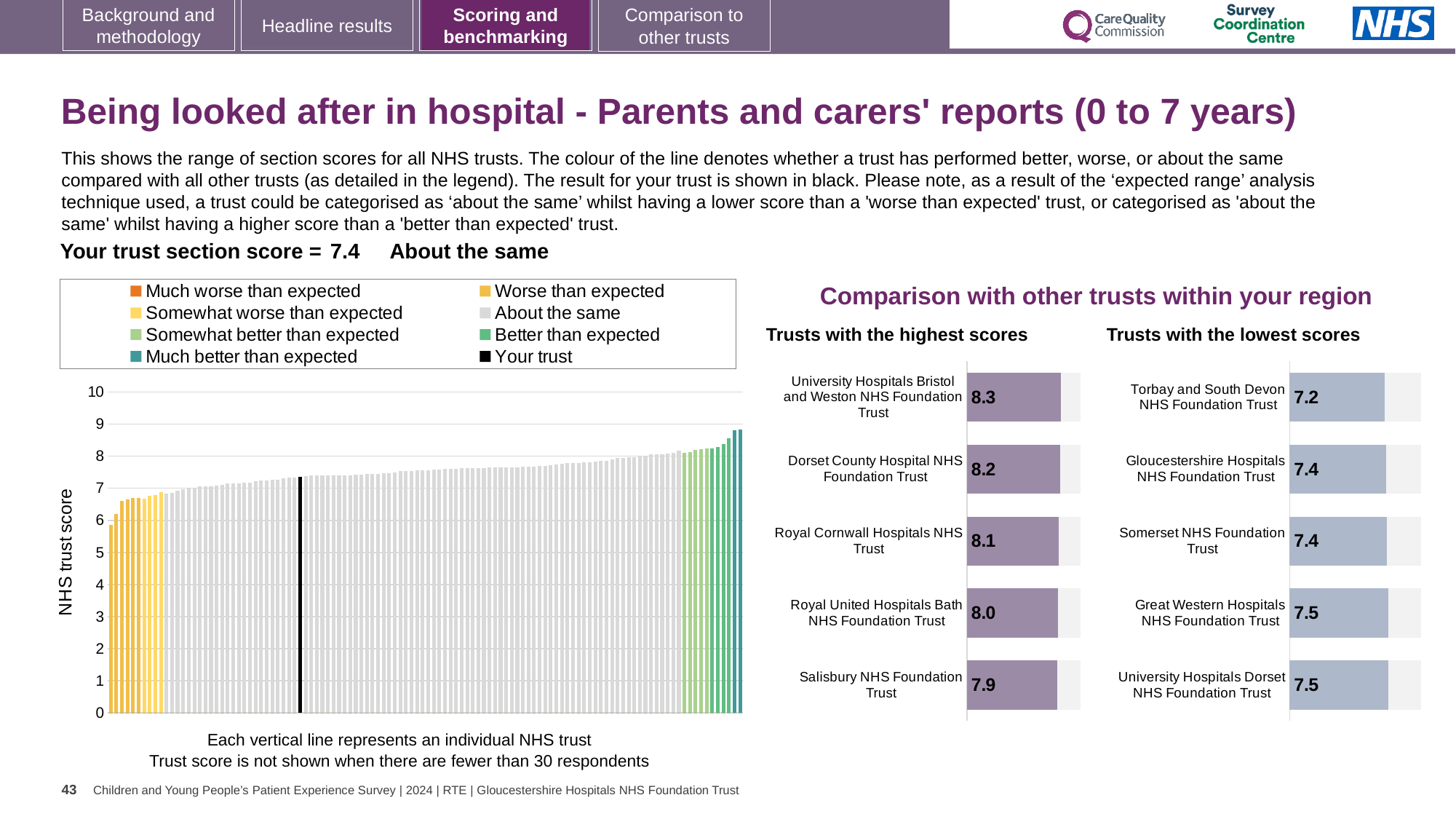
In the 'Trusts with the lowest scores' chart, which trust has the lowest score? Torbay and South Devon NHS Foundation Trust In the 'Trusts with the lowest scores' chart, what is the score for Gloucestershire Hospitals NHS Foundation Trust? 7.4 How many trusts are shown in the 'Trusts with the highest scores' chart? 5 What kind of chart is the main chart on the left showing all NHS trusts? Bar chart In the main chart on the left, is the value of the black bar (your trust) greater or less than 7? greater What is the y-axis label of the main chart on the left? NHS trust score In the 'Trusts with the highest scores' chart, what is the difference between the scores of University Hospitals Bristol and Weston NHS Foundation Trust and Salisbury NHS Foundation Trust? 0.4 In the 'Trusts with the highest scores' chart, what is the score for University Hospitals Bristol and Weston NHS Foundation Trust? 8.3 How many entries does the legend of the main chart on the left list? 8 Comparing the two regional charts, which has the higher score: Royal Cornwall Hospitals NHS Trust or Great Western Hospitals NHS Foundation Trust? Royal Cornwall Hospitals NHS Trust In the 'Trusts with the lowest scores' chart, what is the score for Torbay and South Devon NHS Foundation Trust? 7.2 In the 'Trusts with the highest scores' chart, which trust has the highest score? University Hospitals Bristol and Weston NHS Foundation Trust